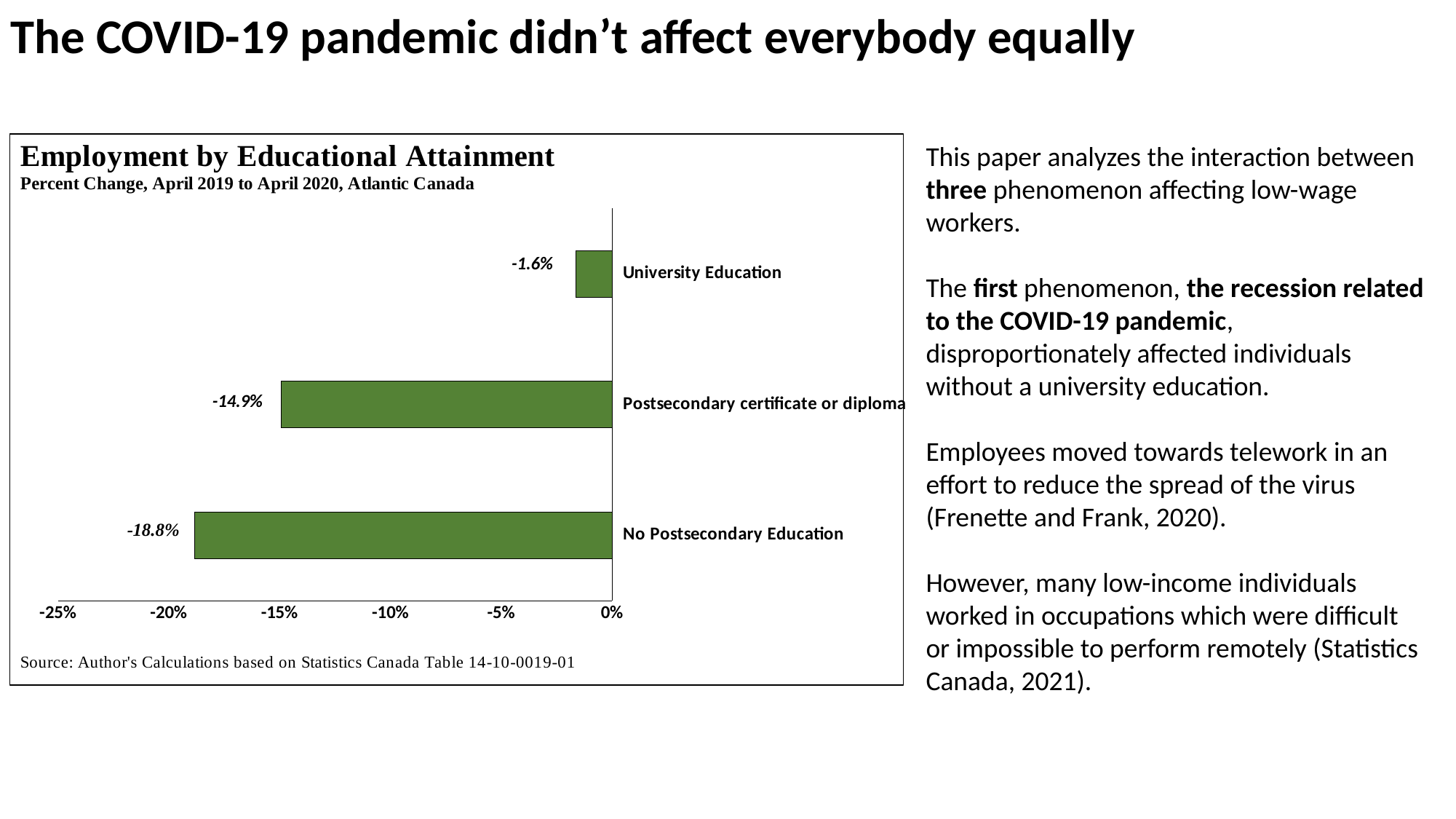
How many educational attainment categories are shown in the chart? 3 What type of chart is used to show Employment by Educational Attainment? Bar chart What time period and region does the chart's subtitle say the percent change covers? April 2019 to April 2020, Atlantic Canada Which educational attainment category shows the largest decline in employment? No Postsecondary Education What is the percent change in employment for No Postsecondary Education? -18.8% What is the percent change in employment for Postsecondary certificate or diploma? -14.9% What is the difference in percentage points between the declines for No Postsecondary Education and University Education? 17.2 percentage points What is the difference in percentage points between the declines for No Postsecondary Education and Postsecondary certificate or diploma? 3.9 percentage points What is the title of the chart? Employment by Educational Attainment What is the percent change in employment for University Education? -1.6% Which educational attainment category shows the smallest decline in employment? University Education Which category had a larger employment decline: Postsecondary certificate or diploma or University Education? Postsecondary certificate or diploma